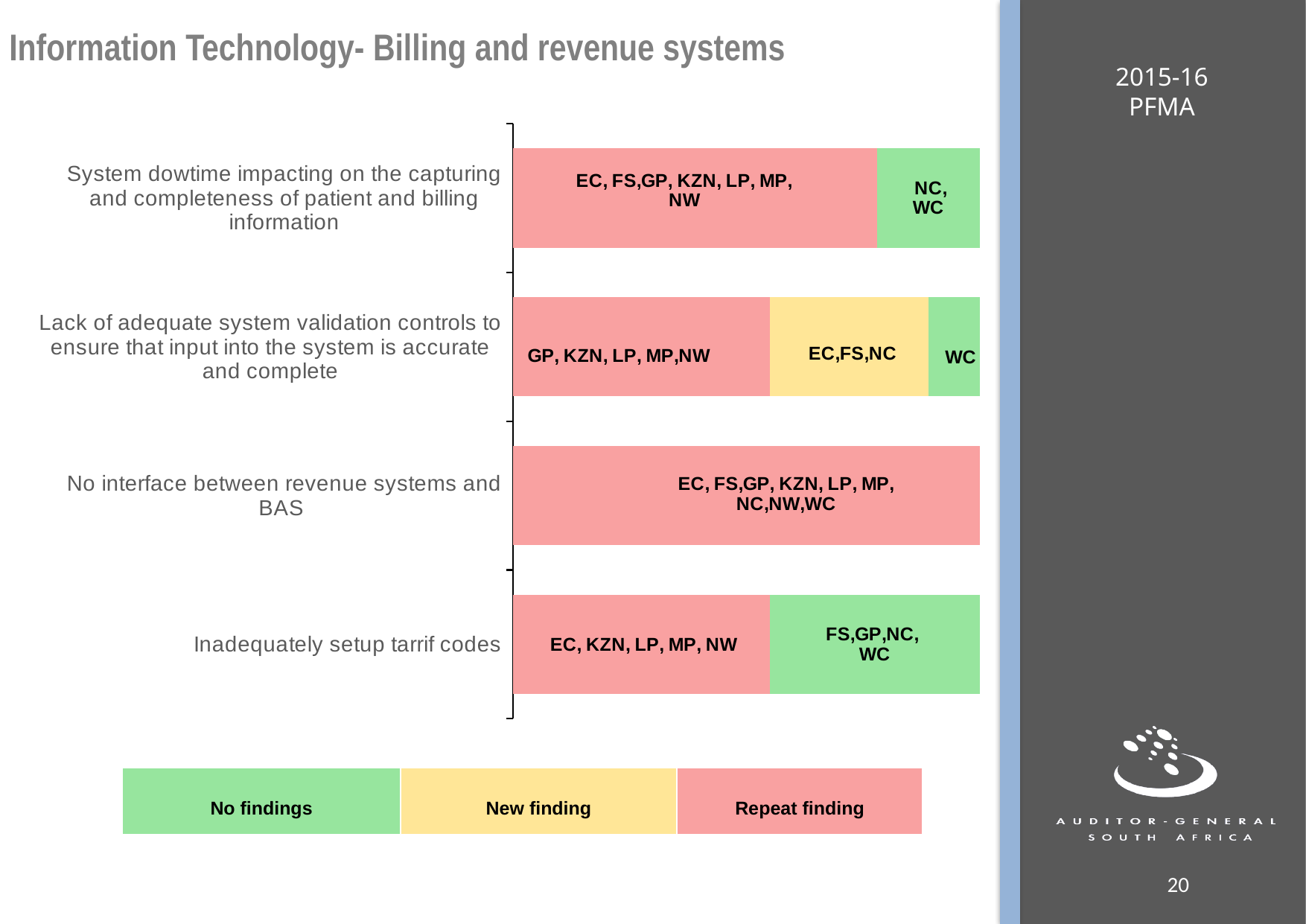
Which finding category is the only one with a 'New finding' segment? Lack of adequate system validation controls to ensure that input into the system is accurate and complete Which provinces are listed as 'New finding' for 'Lack of adequate system validation controls to ensure that input into the system is accurate and complete'? EC, FS, NC Which provinces are listed as 'Repeat finding' for 'Inadequately setup tarrif codes'? EC, KZN, LP, MP, NW Which provinces are listed as 'No findings' for 'System dowtime impacting on the capturing and completeness of patient and billing information'? NC, WC For 'Inadequately setup tarrif codes', is the 'Repeat finding' segment or the 'No findings' segment larger? Repeat finding How many series does the legend list? 3 What kind of chart is shown on the slide? Stacked bar chart How many finding categories (bars) does the chart show? 4 Which finding category has all provinces shown as 'Repeat finding'? No interface between revenue systems and BAS Which colour represents 'No findings' in the legend? Green Which colour represents 'Repeat finding' in the legend? Red Which province is listed as 'No findings' for 'Lack of adequate system validation controls to ensure that input into the system is accurate and complete'? WC